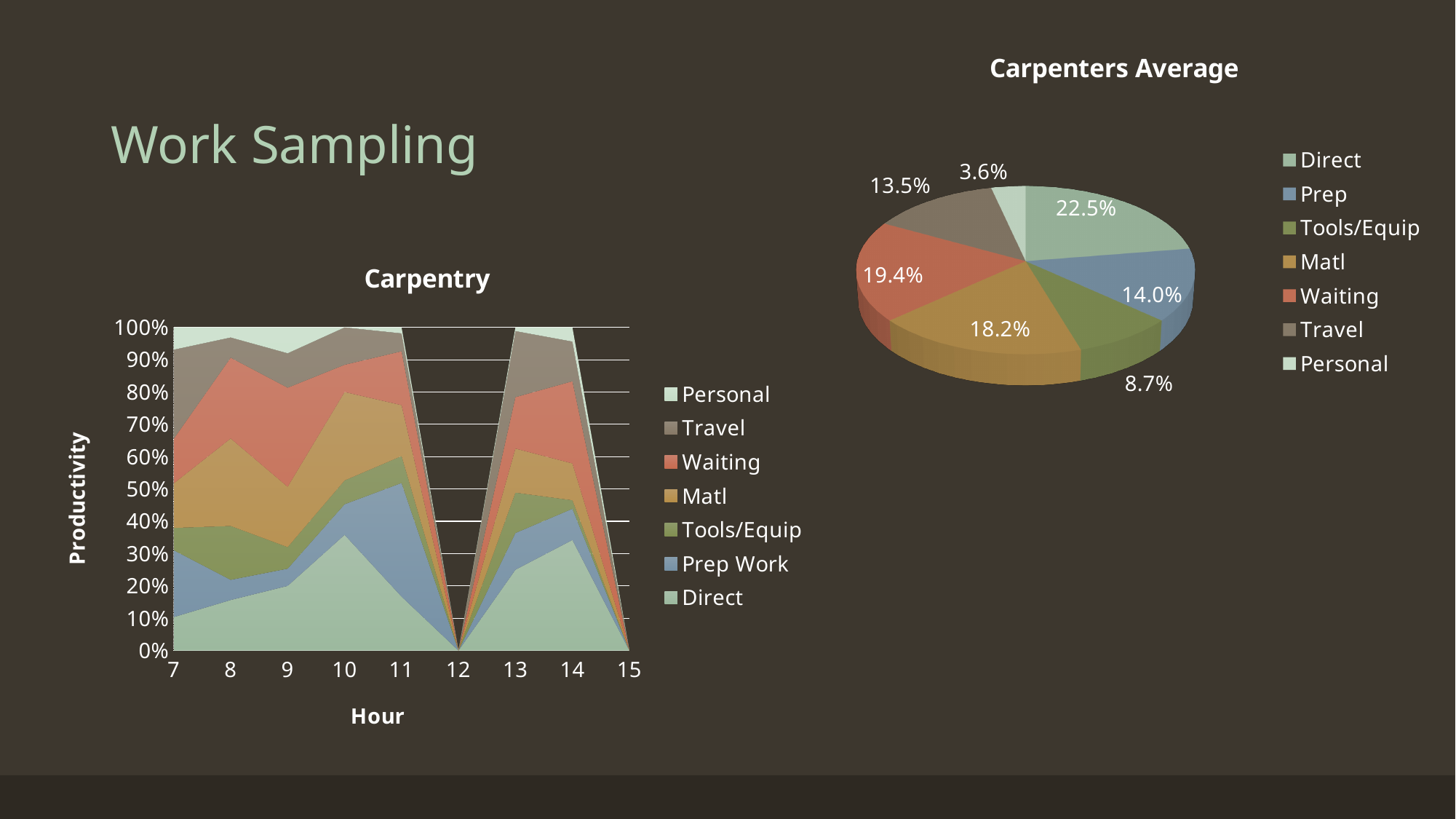
How many categories does the legend of the Carpenters Average chart list? 7 What kind of chart is the Carpentry chart? Stacked area chart In the Carpentry chart, is the Direct value at hour 10 greater or less than 30%? greater In the Carpenters Average chart, what is the value for Waiting? 19.4% In the Carpenters Average chart, which is larger, Prep or Travel? Prep How many hours are shown on the x axis of the Carpentry chart? 9 In the Carpenters Average chart, what is the value for Tools/Equip? 8.7% In the Carpenters Average chart, which category has the smallest slice? Personal In the Carpenters Average chart, what share does Direct have? 22.5% In the Carpenters Average chart, what is the difference between the Waiting and Matl shares? 1.2% What is the y-axis title of the Carpentry chart? Productivity In the Carpenters Average chart, which category has the largest slice? Direct